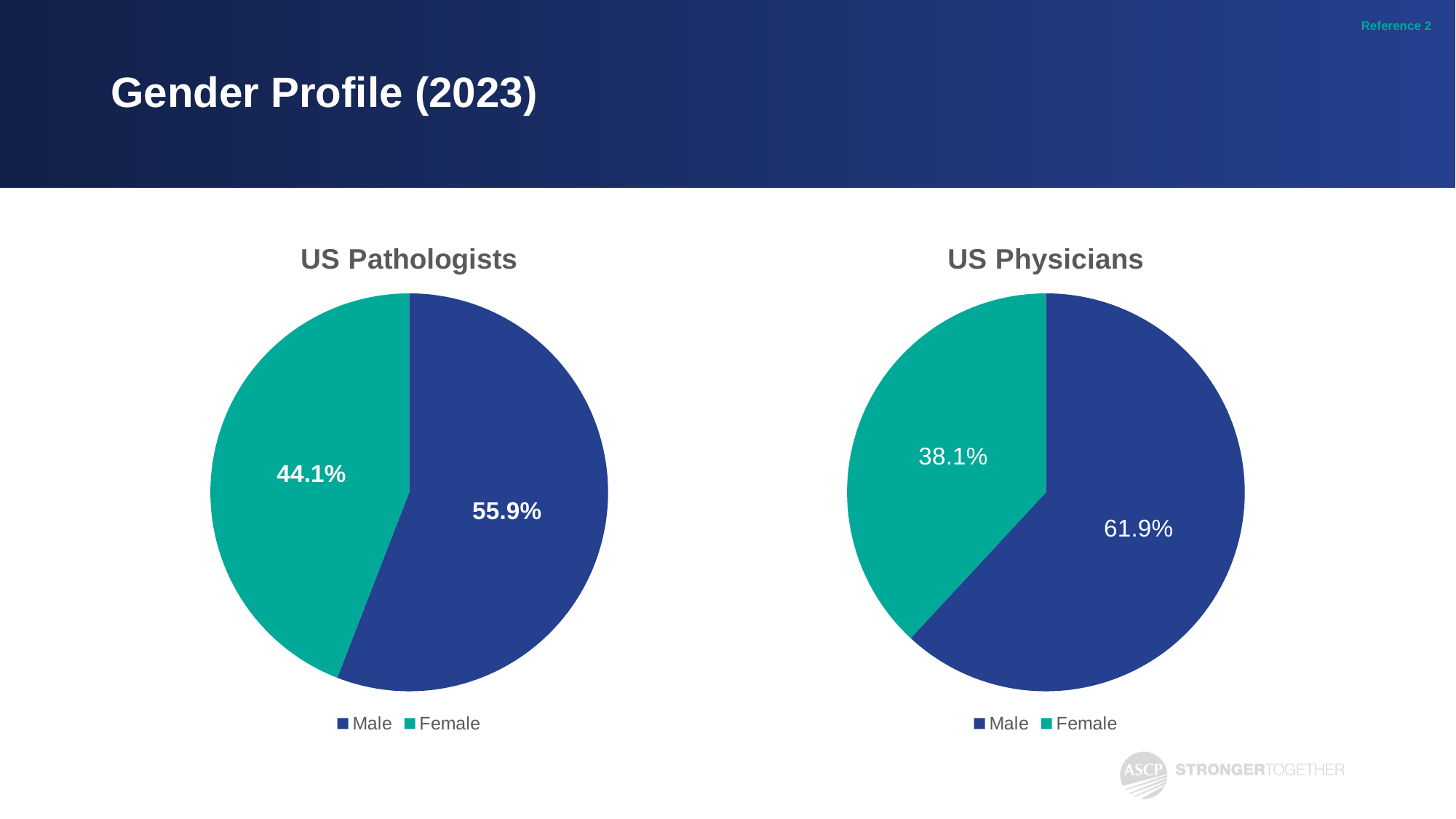
How many entries does the legend of the US Physicians chart list? 2 In the US Pathologists chart, what percentage is Male? 55.9% In the US Pathologists chart, what percentage is Female? 44.1% How many slices does the US Pathologists pie chart have? 2 In the US Physicians chart, what percentage is Male? 61.9% Is the Female share larger in the US Pathologists chart or the US Physicians chart? US Pathologists In the US Physicians chart, which slice is the smallest? Female In the US Physicians chart, what percentage is Female? 38.1% In the US Physicians chart, what is the difference between the Male and Female percentages? 23.8% In the US Pathologists chart, what is the difference between the Male and Female percentages? 11.8% What type of chart is the US Physicians chart? Pie chart In the US Pathologists chart, which slice is the largest? Male